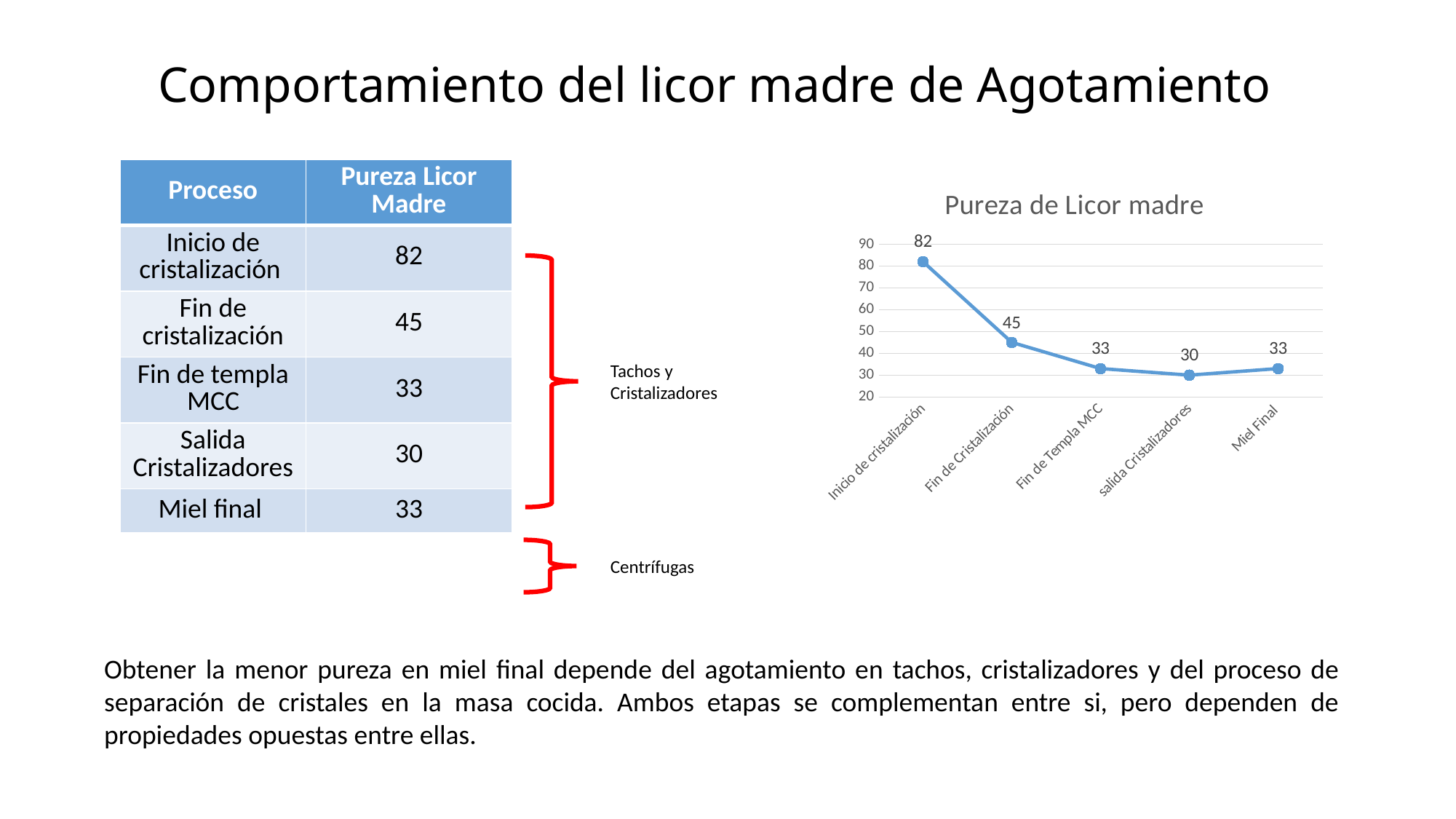
Do the values generally rise or fall from Inicio de cristalización to salida Cristalizadores? fall How many data points are plotted in the chart? 5 Which is larger, the value for Fin de Cristalización or the value for Miel Final? Fin de Cristalización Which category has the lowest value in the chart? salida Cristalizadores What kind of chart is shown on the slide? line chart What is the value for Fin de Cristalización in the chart? 45 Is the value for Fin de Templa MCC greater or less than 40? less What is the value for Inicio de cristalización in the chart? 82 Which category has the highest value in the chart? Inicio de cristalización What is the difference between the values for Inicio de cristalización and Fin de Cristalización? 37 What is the title of the chart? Pureza de Licor madre What is the value for salida Cristalizadores in the chart? 30